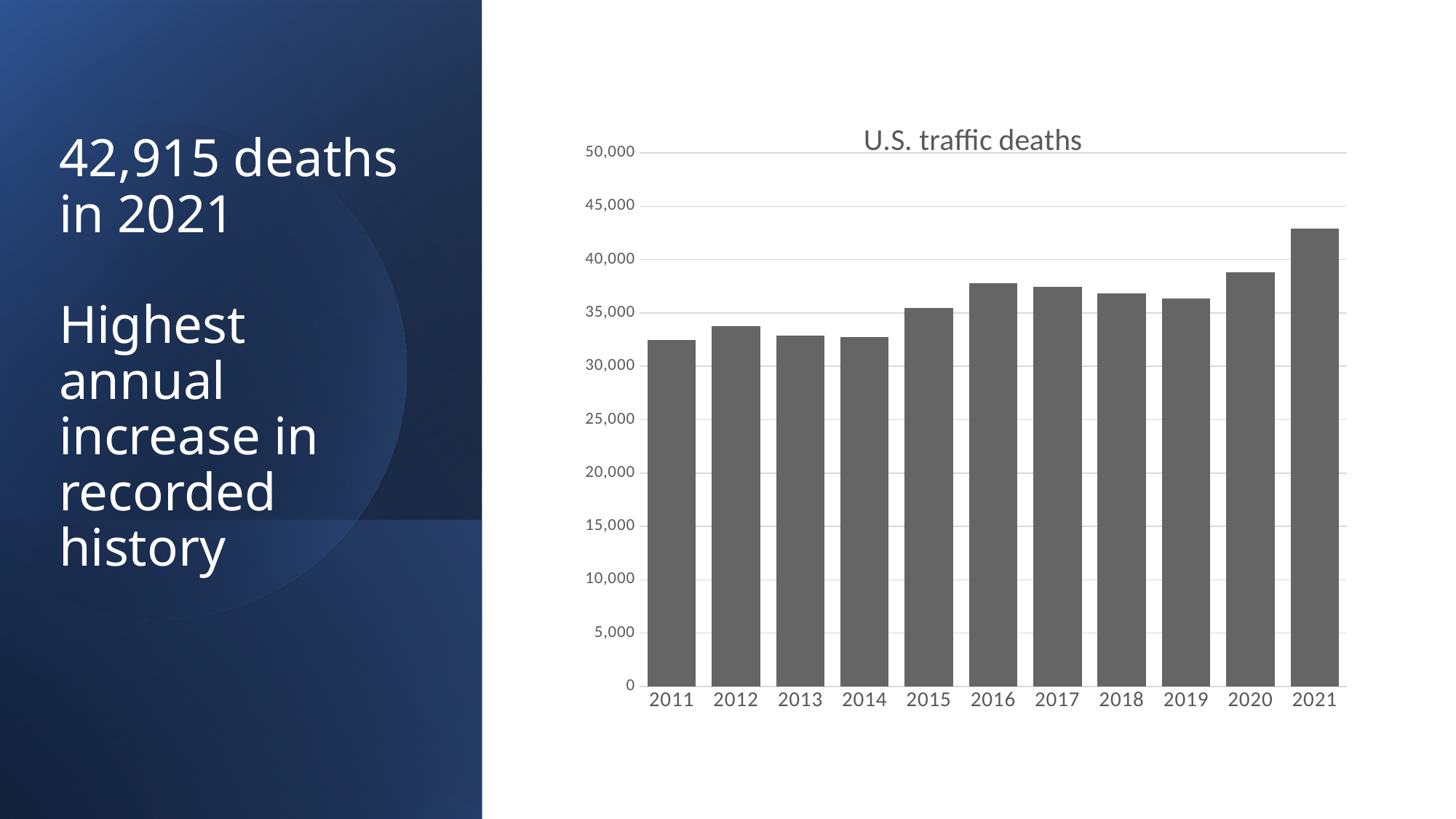
How many years are shown on the x axis of the chart? 11 Which year has more traffic deaths, 2011 or 2016? 2016 Is the value for 2011 greater or less than 30,000? greater Is the value for 2021 greater or less than 40,000? greater Which year has the highest number of U.S. traffic deaths in the chart? 2021 Is the value for 2016 greater or less than 40,000? less Overall, do U.S. traffic deaths rise or fall from 2011 to 2021? rise Which year has more traffic deaths, 2019 or 2020? 2020 What is the title of the chart? U.S. traffic deaths How many U.S. traffic deaths were there in 2021, according to the slide? 42,915 What kind of chart is shown on the slide? bar chart